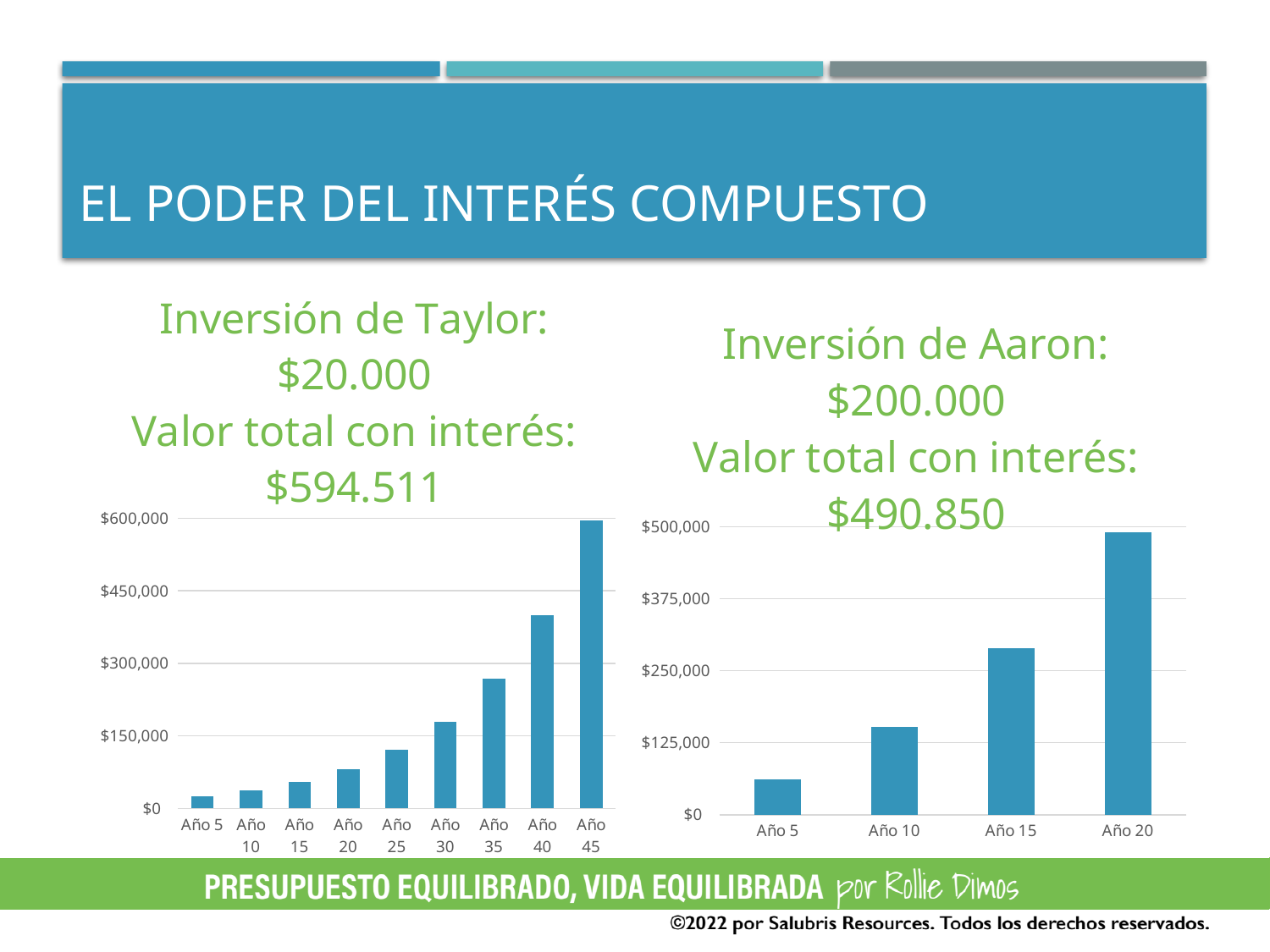
On the left chart (Inversión de Taylor), do the values rise or fall from Año 5 to Año 45? rise On the right chart (Inversión de Aaron), which year has the highest value? Año 20 On the right chart (Inversión de Aaron), is the value for Año 15 greater or less than $250,000? greater On the left chart (Inversión de Taylor), how many years are plotted? 9 On the right chart (Inversión de Aaron), how many years are plotted? 4 What kind of chart is the right chart (Inversión de Aaron)? bar chart On the left chart (Inversión de Taylor), which year has the lowest value? Año 5 On the left chart (Inversión de Taylor), which year has the highest value? Año 45 On the right chart (Inversión de Aaron), is the value for Año 5 greater or less than $125,000? less On the right chart (Inversión de Aaron), which is larger, the value for Año 10 or the value for Año 15? Año 15 On the left chart (Inversión de Taylor), is the value for Año 25 greater or less than $150,000? less